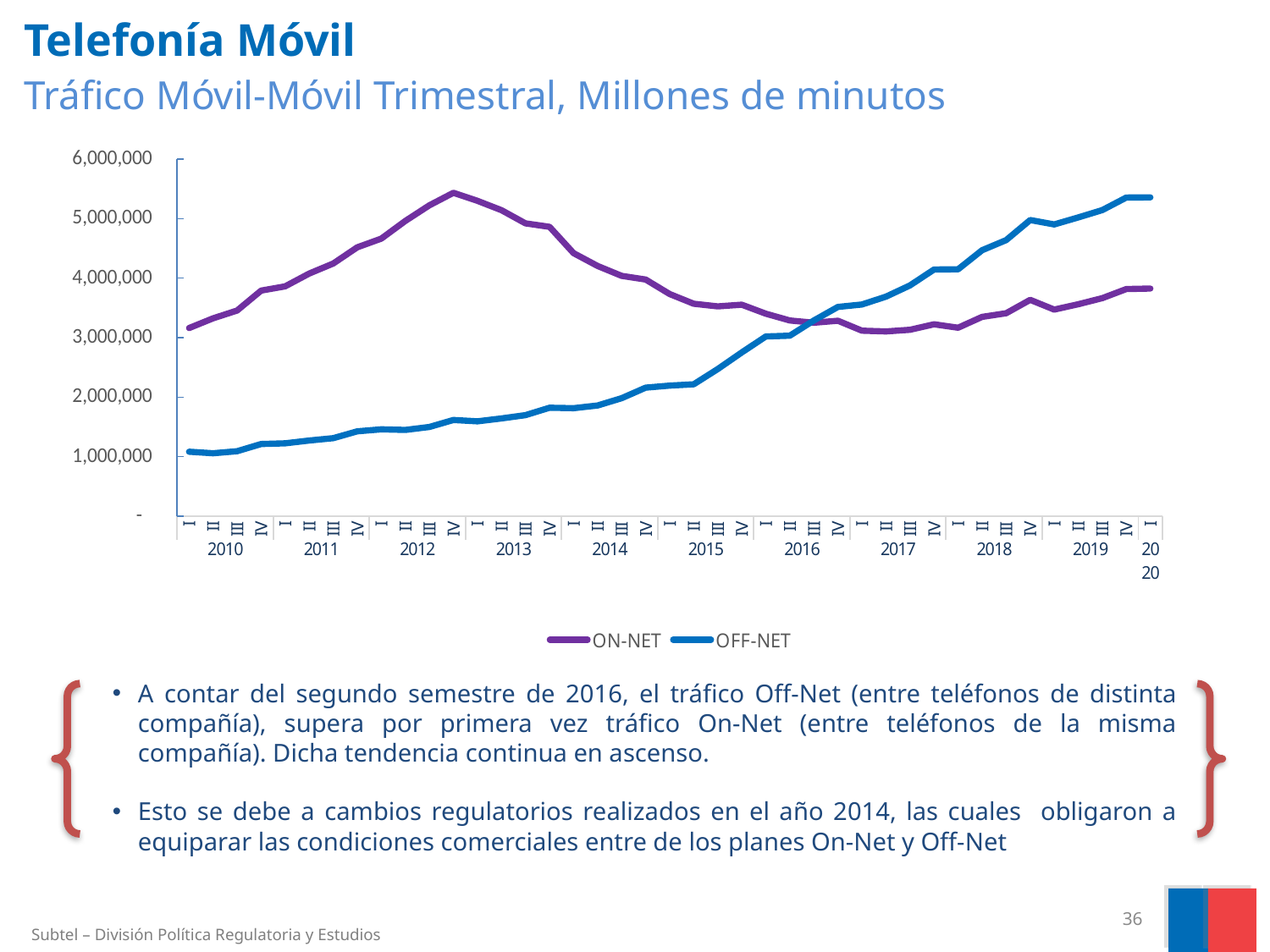
Is the OFF-NET value in quarter I of 2015 greater or less than 3,000,000? less In quarter IV of 2012, which series has the larger value, ON-NET or OFF-NET? ON-NET Does the ON-NET line rise or fall between quarter IV of 2012 and quarter I of 2016? fall What are the two series named in the legend? ON-NET and OFF-NET Is the ON-NET value in quarter IV of 2018 greater or less than 3,000,000? greater In quarter IV of 2019, which series has the larger value, ON-NET or OFF-NET? OFF-NET Is the OFF-NET value in quarter I of 2010 greater or less than 2,000,000? less Does the OFF-NET line generally rise or fall from 2010 to 2020? rise What kind of chart is shown on the slide? line chart What colour is the OFF-NET line? blue How many series does the legend list? 2